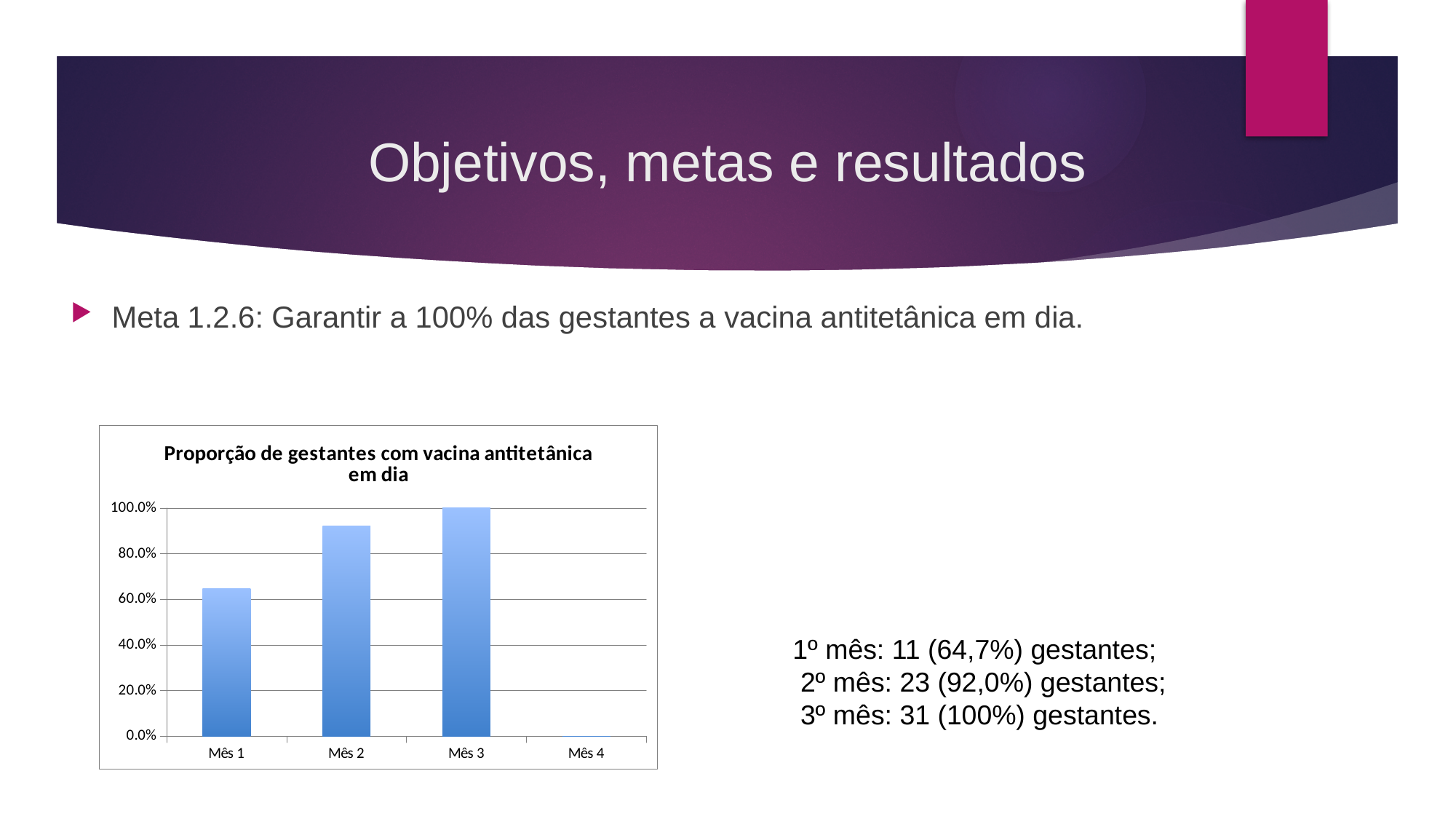
Which month has the highest bar in the chart? Mês 3 What is the title of the chart? Proporção de gestantes com vacina antitetânica em dia What kind of chart is shown on the slide? bar chart Is the value for Mês 1 greater or less than 80.0%? less Among the months with a bar, which has the lowest value? Mês 1 Is the value for Mês 1 greater or less than 60.0%? greater Which month on the x axis has no bar plotted? Mês 4 How many categories are labelled on the x axis of the chart? 4 What value does the bar for Mês 3 reach on the y axis? 100.0% Do the values rise or fall from Mês 1 to Mês 3? rise Is the value for Mês 2 greater or less than 80.0%? greater Which is larger, the value for Mês 1 or the value for Mês 2? Mês 2